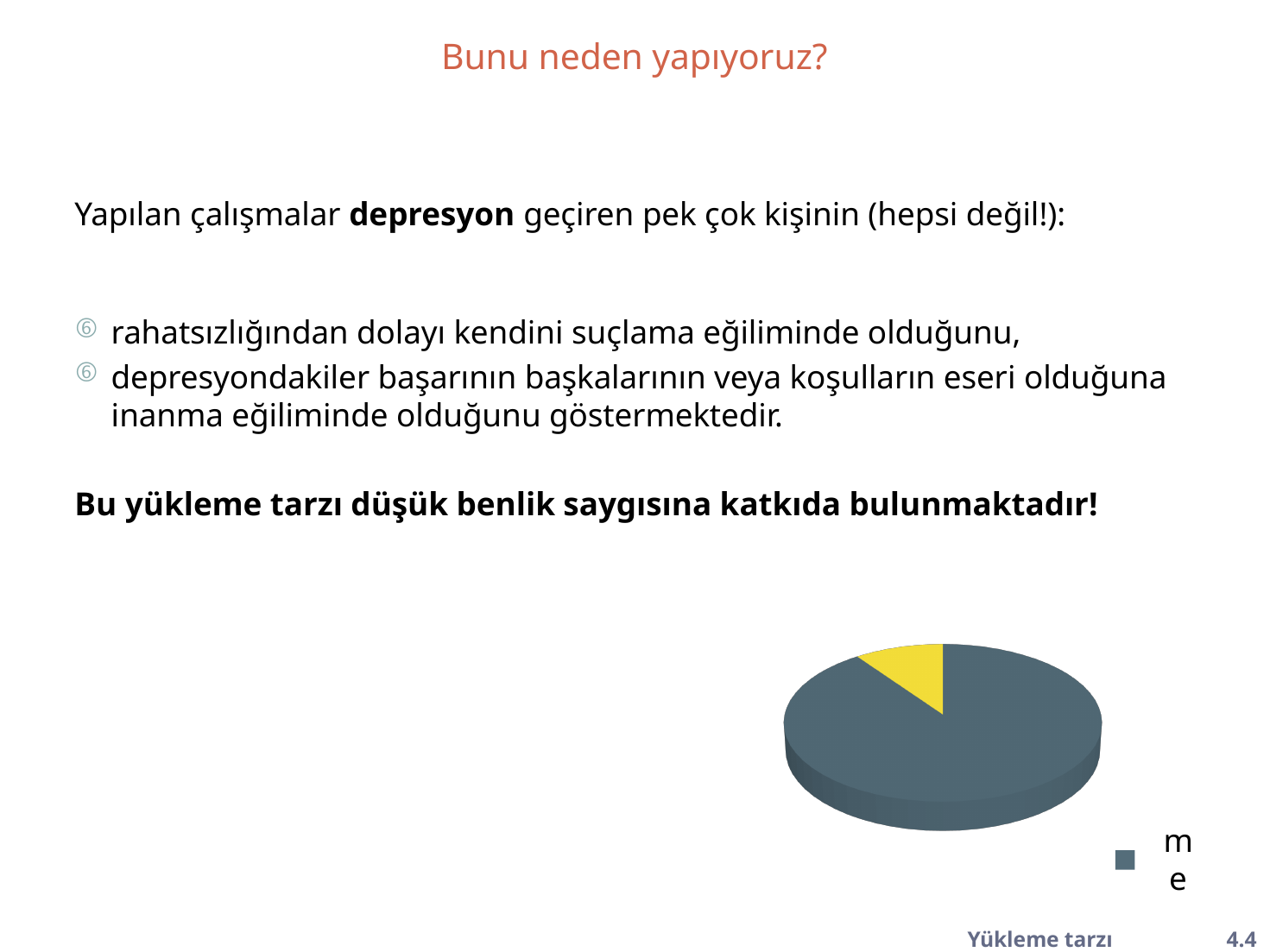
Which slice of the pie chart is the smallest? the yellow slice Is the pie chart drawn in 3D or flat 2D? 3D Is the dark grey-blue slice's share of the pie greater or less than 50%? greater Which slice of the pie chart is larger, the yellow slice or the dark grey-blue slice? the dark grey-blue slice How many slices does the pie chart have? 2 What colour is the largest slice of the pie chart? dark grey-blue What kind of chart is shown on the slide? pie chart Is the yellow slice's share of the pie greater or less than 50%? less